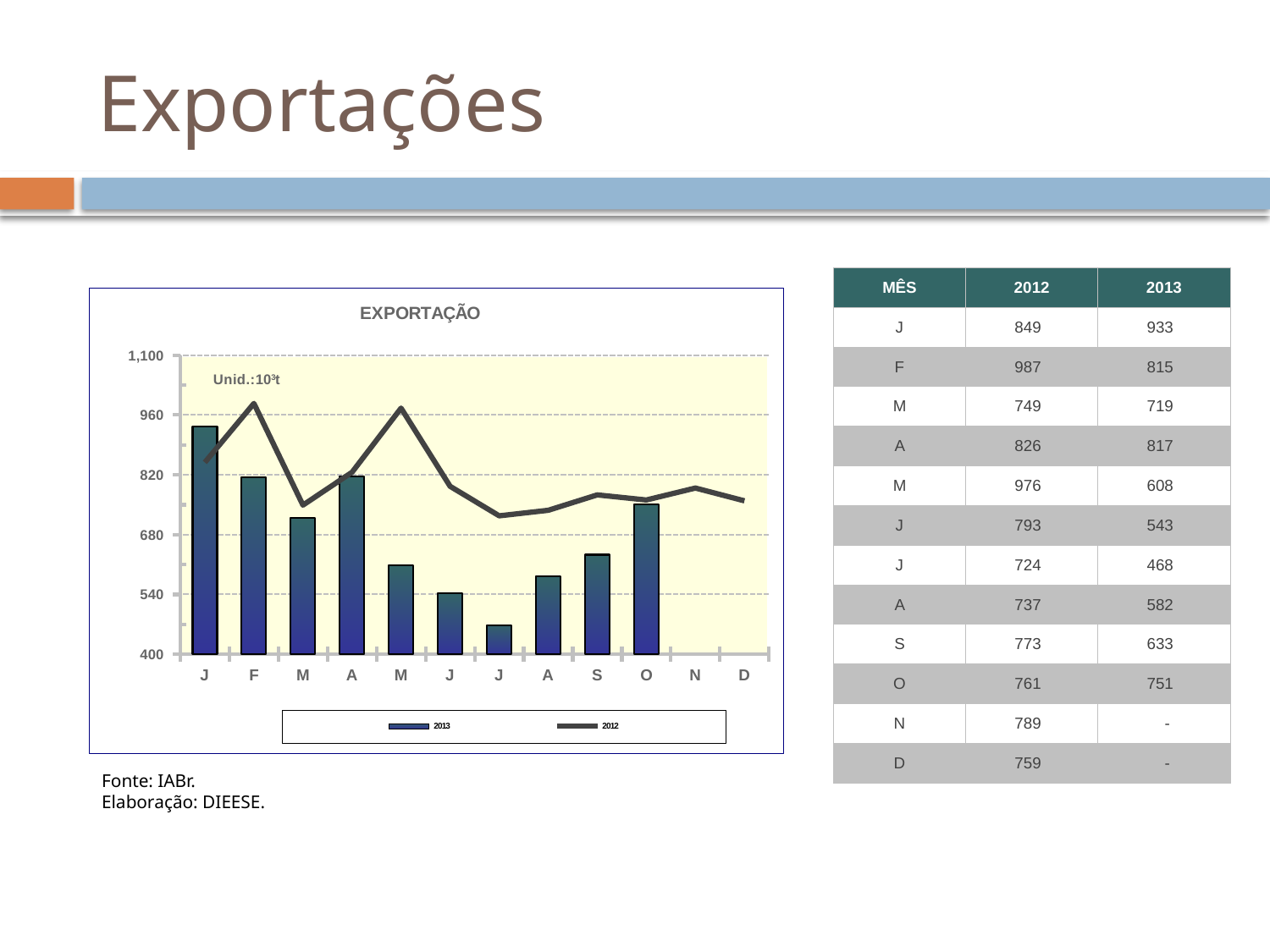
Do the 2013 bars rise or fall from January (first J) to July (second J)? fall Which month has the highest 2013 bar in the EXPORTAÇÃO chart? J (January) Which month has the lowest 2013 bar in the EXPORTAÇÃO chart? J (July) Is the 2012 value for F greater or less than 960? greater Is the 2013 value for May (the second M) greater or less than 680? less What is the 2013 value for O? 751 How many series does the legend of the EXPORTAÇÃO chart list? 2 What kind of chart is shown on the slide? bar chart with a line What unit label is printed inside the EXPORTAÇÃO chart? Unid.:10³t How many month categories are shown on the x axis of the EXPORTAÇÃO chart? 12 What is the difference between the 2012 and 2013 values for F? 172 For January (the first J), which series is larger, 2012 or 2013? 2013